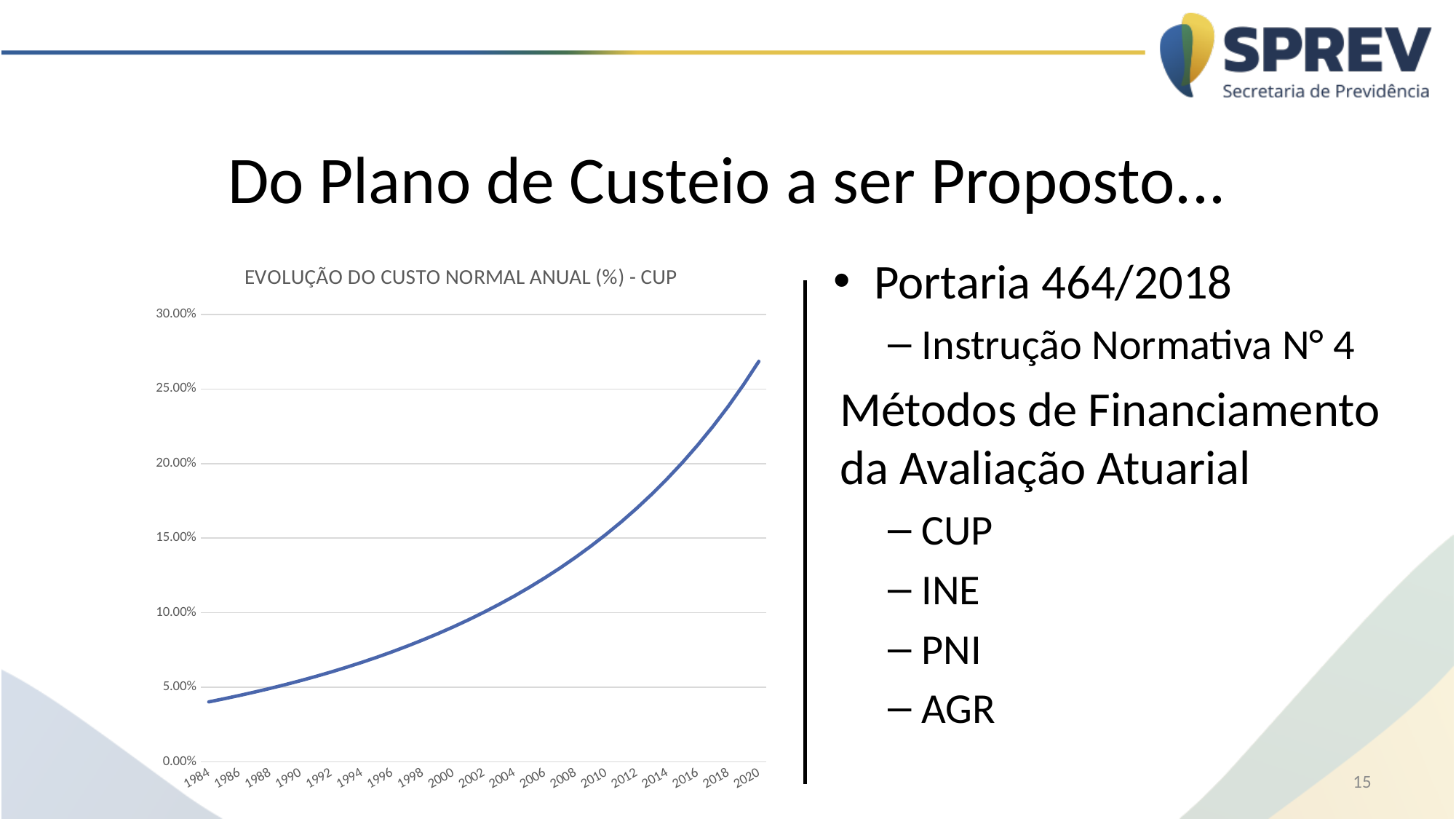
In which year is the plotted value highest? 2020 Is the value for 1984 greater or less than 5.00%? less Is the value for 2018 greater or less than 25.00%? less In which year is the plotted value lowest? 1984 What is the highest value shown on the y axis? 30.00% Is the value for 2020 greater or less than 25.00%? greater What kind of chart is shown on the slide? Line chart Does the value rise or fall along the x axis from 1984 to 2020? Rises What is the title of the chart? EVOLUÇÃO DO CUSTO NORMAL ANUAL (%) - CUP How many year labels are shown on the x axis? 19